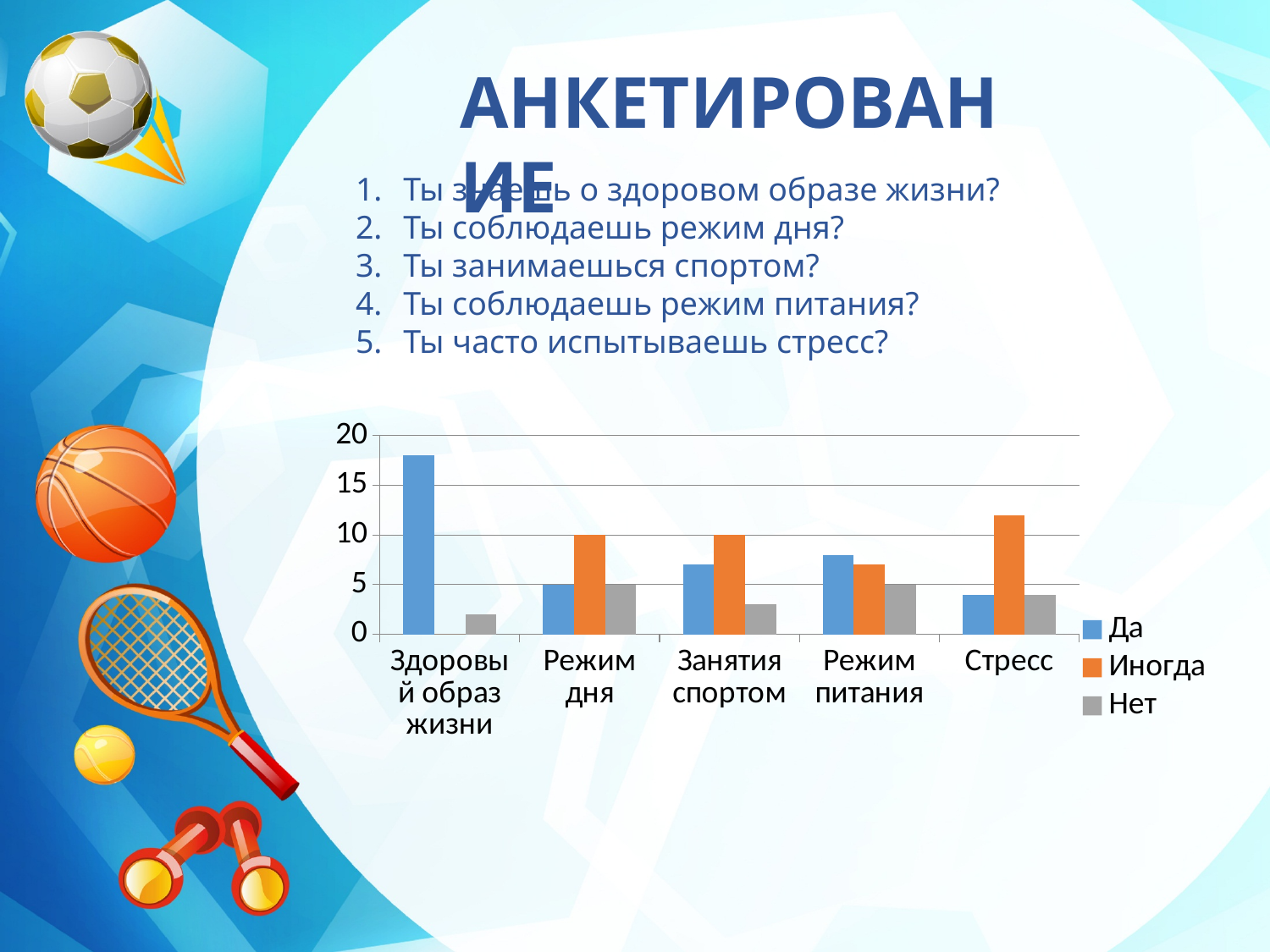
What are the three legend entries of the chart? Да, Иногда, Нет Which category has the highest value for the "Иногда" series? Стресс What is the "Нет" value for "Режим питания"? 5 What kind of chart is shown on the slide? bar chart Is the "Да" value for "Здоровый образ жизни" greater or less than 15? greater How many series does the chart legend list? 3 Which is larger for "Занятия спортом": the "Иногда" value or the "Нет" value? Иногда Is the "Иногда" value for "Стресс" greater or less than 10? greater Is the "Нет" value for "Здоровый образ жизни" greater or less than 5? less What is the "Иногда" value for "Режим дня"? 10 Which category has the highest value for the "Да" series? Здоровый образ жизни How many categories are shown on the x axis of the chart? 5